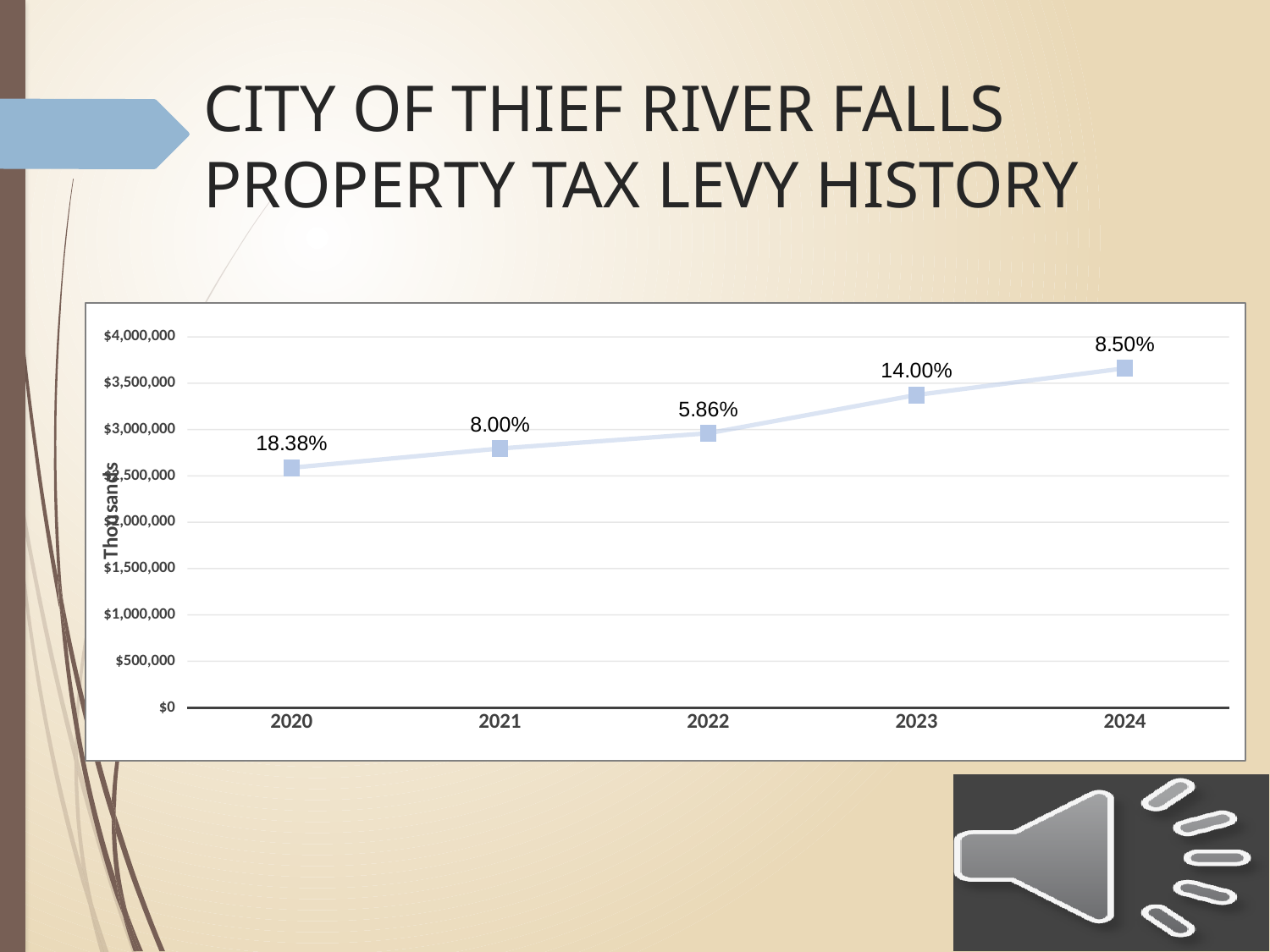
What percentage label is shown at the 2020 data point? 18.38% What percentage label is shown at the 2024 data point? 8.50% Is the plotted value for 2024 greater or less than $3,500,000? greater What kind of chart is shown on the slide? line chart Do the plotted values rise or fall from 2020 to 2024? rise Which year has the larger plotted value, 2021 or 2023? 2023 How many years are plotted along the x axis? 5 Which year has the lowest plotted levy value? 2020 What percentage label is shown at the 2023 data point? 14.00% Which year has the highest plotted levy value? 2024 Is the plotted value for 2020 greater or less than $3,000,000? less What percentage label is shown at the 2022 data point? 5.86%